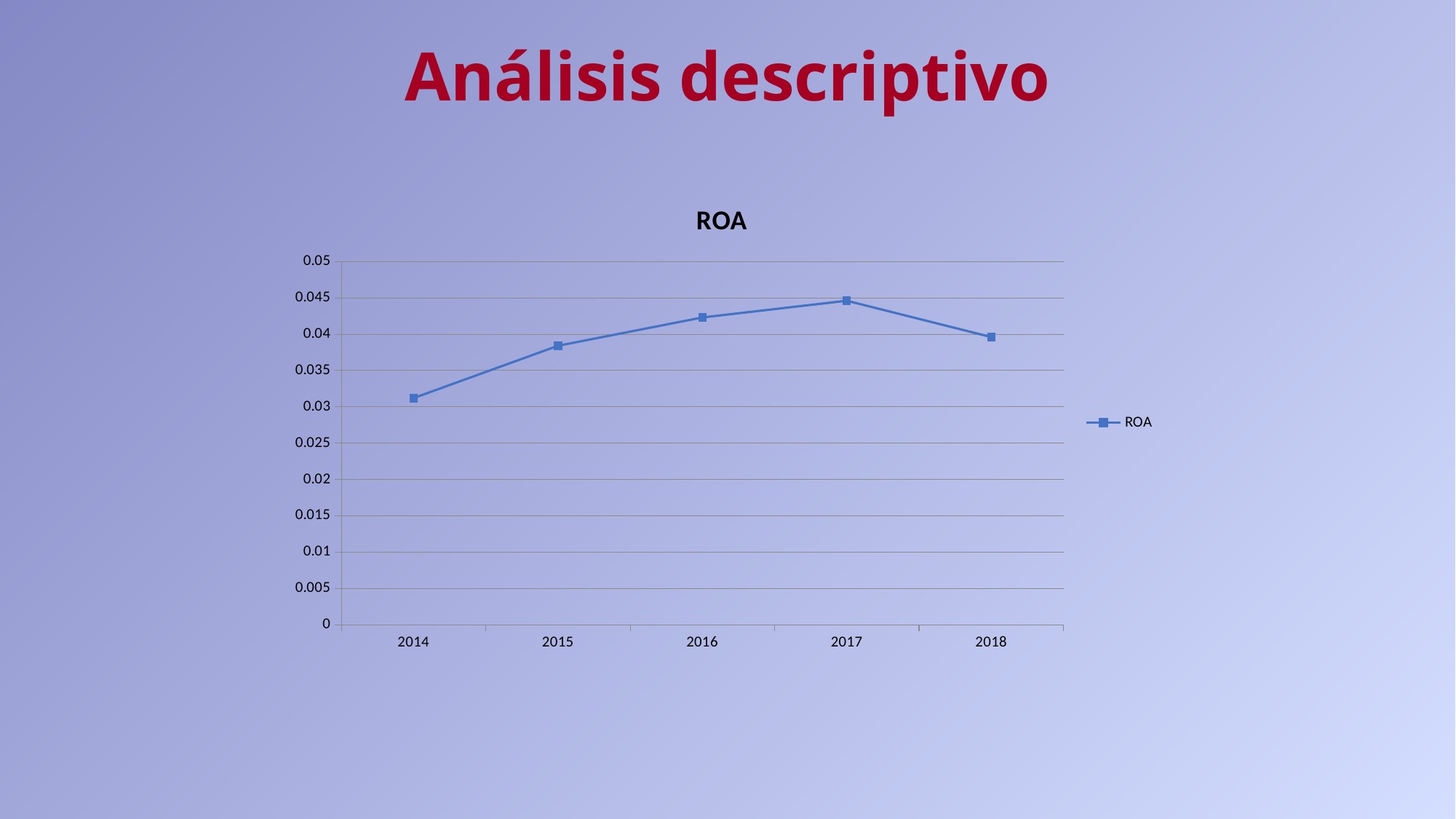
Is the ROA value for 2017 greater or less than 0.04? greater Which year has the larger ROA value, 2015 or 2016? 2016 Which year has the larger ROA value, 2014 or 2017? 2017 In which year is the ROA value lowest? 2014 How many years are plotted on the x axis? 5 Does the ROA value rise or fall from 2014 to 2017? rise Is the ROA value for 2014 greater or less than 0.035? less What is the title of the chart? ROA What kind of chart is shown on the slide? line chart How many series does the legend list? 1 Is the ROA value for 2018 greater or less than 0.035? greater In which year is the ROA value highest? 2017